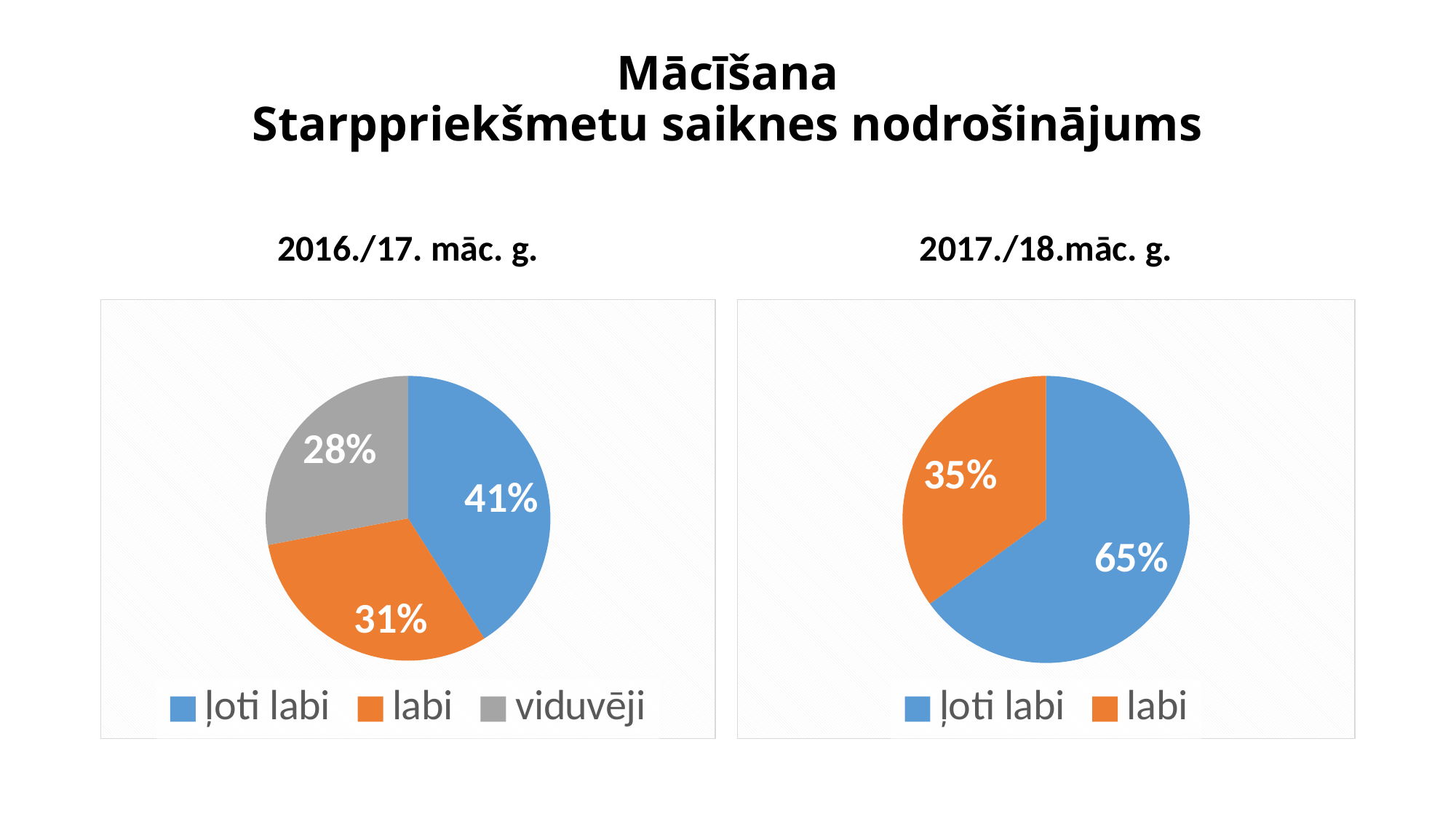
In the 2016./17. māc. g. chart, which category has the largest slice? ļoti labi In the 2016./17. māc. g. chart, which is larger: 'ļoti labi' or 'labi'? ļoti labi In the 2017./18.māc. g. chart, what share does 'labi' have? 35% In the 2016./17. māc. g. chart, what share does 'viduvēji' have? 28% In the 2017./18.māc. g. chart, what is the difference between the 'ļoti labi' and 'labi' shares? 30% In the 2016./17. māc. g. chart, which category has the smallest slice? viduvēji In the 2016./17. māc. g. chart, what is the difference between the 'labi' and 'viduvēji' shares? 3% In the 2017./18.māc. g. chart, what share does 'ļoti labi' have? 65% In the 2016./17. māc. g. chart, what share does 'ļoti labi' have? 41% How many entries does the legend of the 2017./18.māc. g. chart list? 2 How many slices does the 2016./17. māc. g. chart have? 3 What kind of chart is the 2017./18.māc. g. chart? pie chart